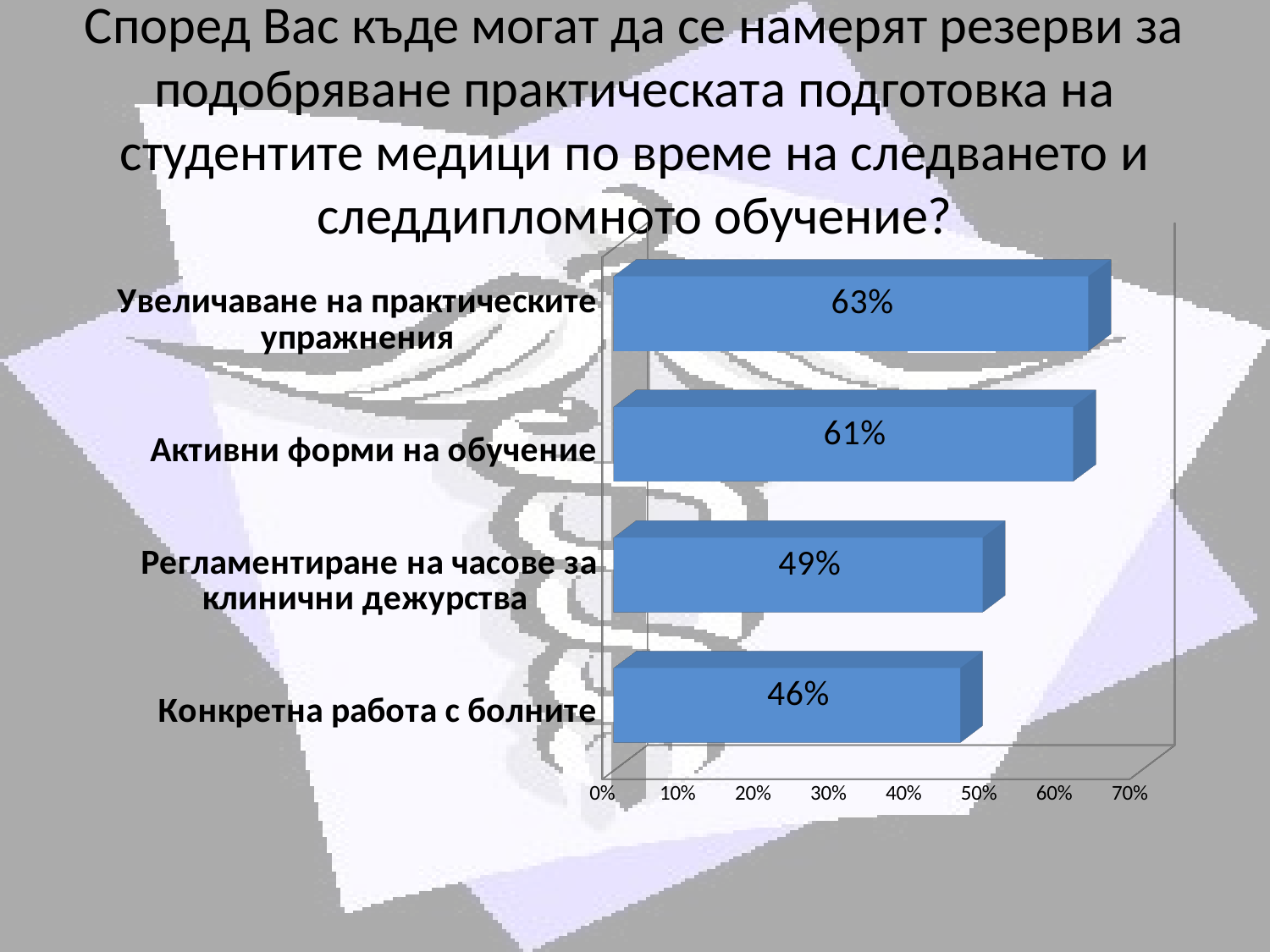
What is the value for "Конкретна работа с болните"? 46% Which is larger, the value for "Регламентиране на часове за клинични дежурства" or for "Конкретна работа с болните"? Регламентиране на часове за клинични дежурства What is the value for "Увеличаване на практическите упражнения"? 63% What is the value for "Активни форми на обучение"? 61% What is the value for "Регламентиране на часове за клинични дежурства"? 49% How many categories are shown in the chart? 4 Which category has the highest value? Увеличаване на практическите упражнения What is the difference between the values for "Увеличаване на практическите упражнения" and "Конкретна работа с болните"? 17% What kind of chart is shown on the slide? bar chart Which category has the lowest value? Конкретна работа с болните Is the value for "Активни форми на обучение" greater or less than 50%? greater What is the difference between the values for "Активни форми на обучение" and "Регламентиране на часове за клинични дежурства"? 12%